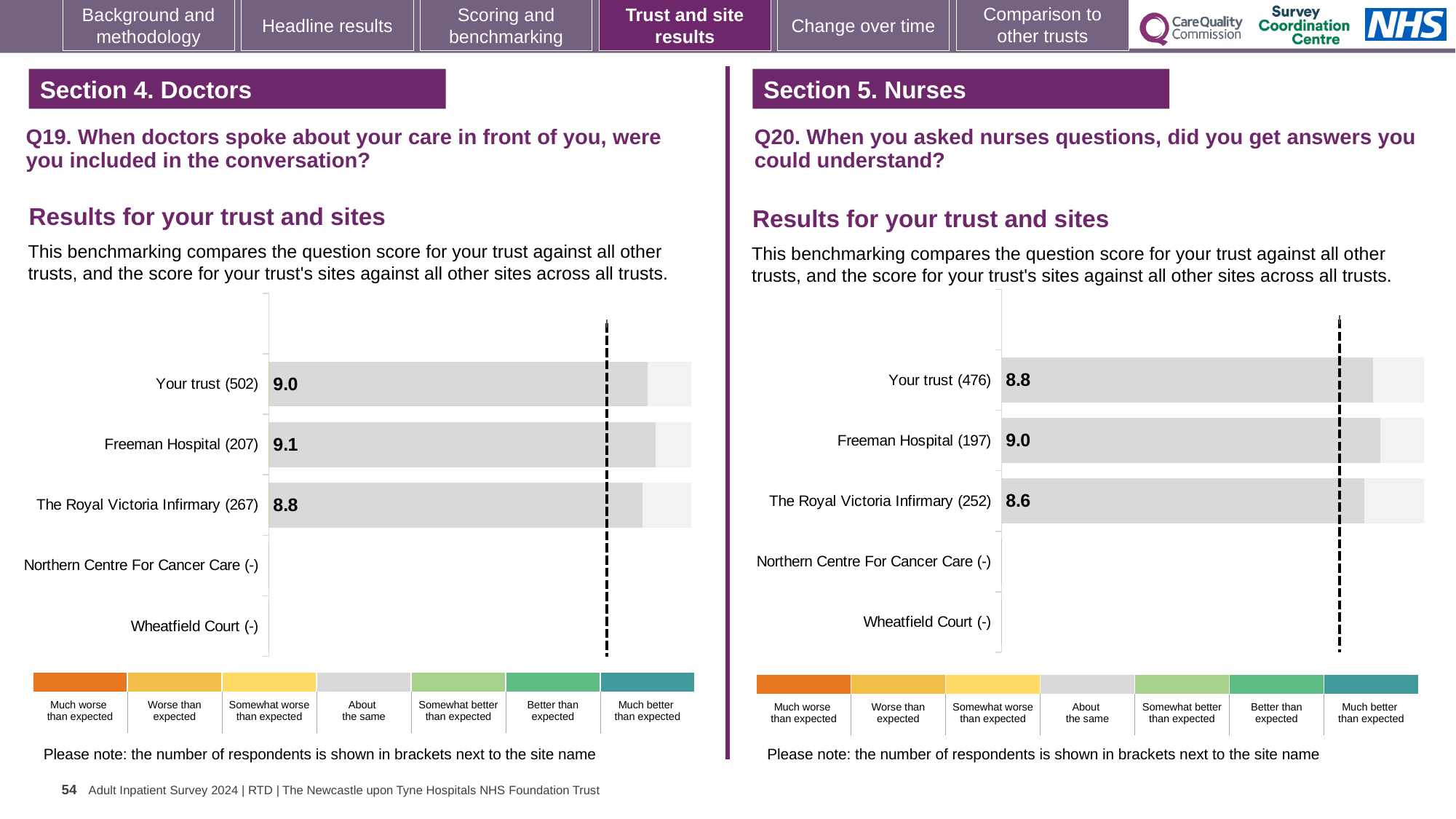
In the Q19 chart on the left, what is the score for Your trust? 9.0 In the Q19 chart on the left, what is the score for Freeman Hospital? 9.1 In the Q20 chart on the right, what is the score for The Royal Victoria Infirmary? 8.6 In the Q20 chart on the right, what is the difference between the scores for Freeman Hospital and The Royal Victoria Infirmary? 0.4 In the Q19 chart on the left, which site or trust has the lowest score shown? The Royal Victoria Infirmary How many sites or trusts are listed on the vertical axis of the Q19 chart on the left? 5 In the Q20 chart on the right, is the score for Freeman Hospital larger or smaller than the score for Your trust? larger What kind of chart is used for the Q20 results on the right? bar chart In the Q20 chart on the right, which site or trust has the highest score shown? Freeman Hospital In the Q19 chart on the left, how many respondents are shown in brackets for Your trust? 502 In the Q19 chart on the left, what is the difference between the scores for Freeman Hospital and The Royal Victoria Infirmary? 0.3 In the Q20 chart on the right, what is the score for Your trust? 8.8